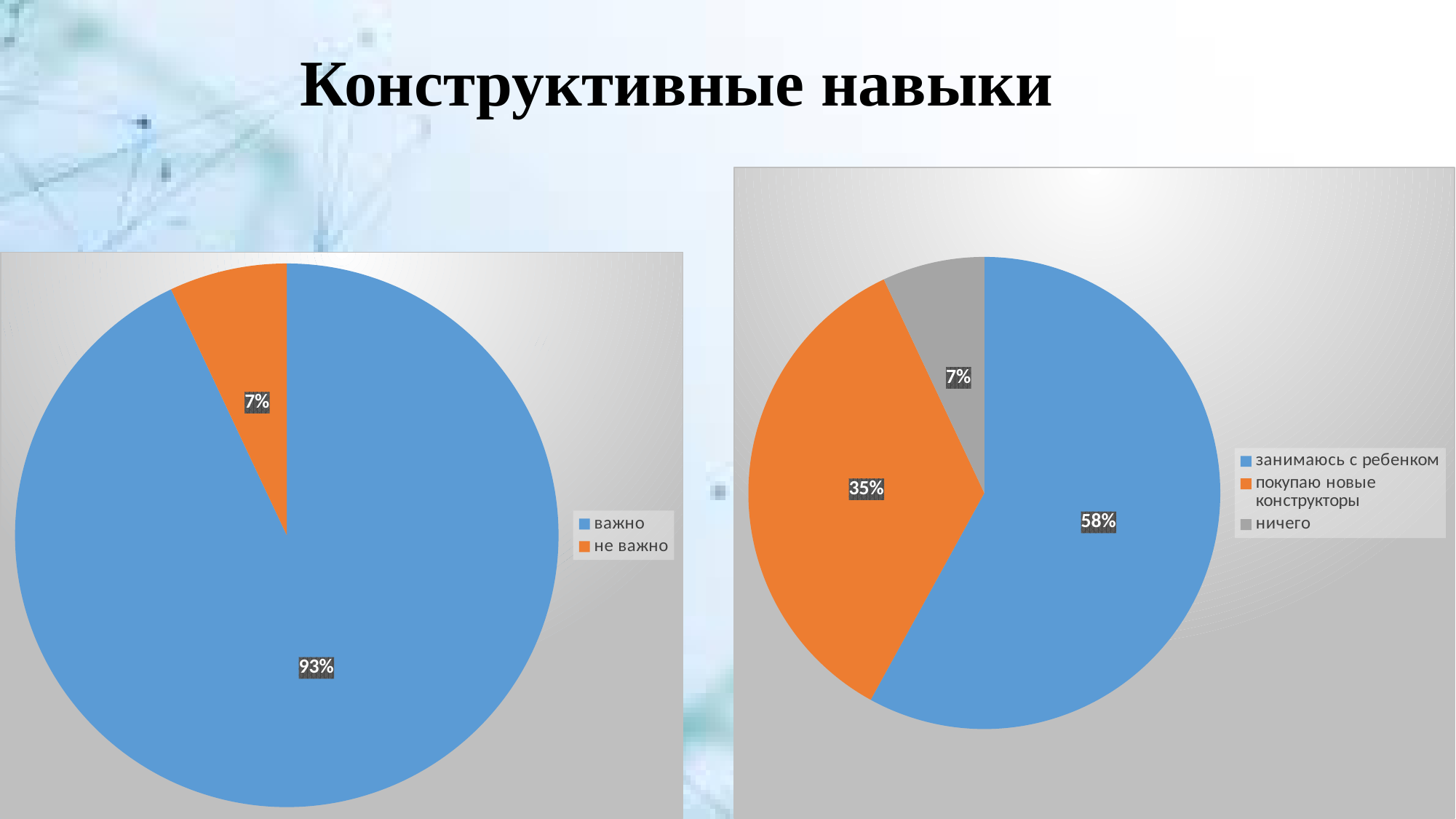
In the right pie chart, what share is labelled for 'занимаюсь с ребенком'? 58% What type of chart is the left chart on the slide? pie chart In the right pie chart, what share is labelled for 'ничего'? 7% In the left pie chart, what share is labelled for 'не важно'? 7% In the right pie chart, what is the difference between the 'занимаюсь с ребенком' and 'покупаю новые конструкторы' shares? 23% In the right pie chart, which category has the largest slice? занимаюсь с ребенком In the right pie chart, which category has the smallest slice? ничего In the right pie chart, which is larger: 'покупаю новые конструкторы' or 'ничего'? покупаю новые конструкторы In the left pie chart, what is the difference between the 'важно' and 'не важно' shares? 86% In the right pie chart, what share is labelled for 'покупаю новые конструкторы'? 35% How many categories does the legend of the right pie chart list? 3 In the left pie chart, what share is labelled for 'важно'? 93%